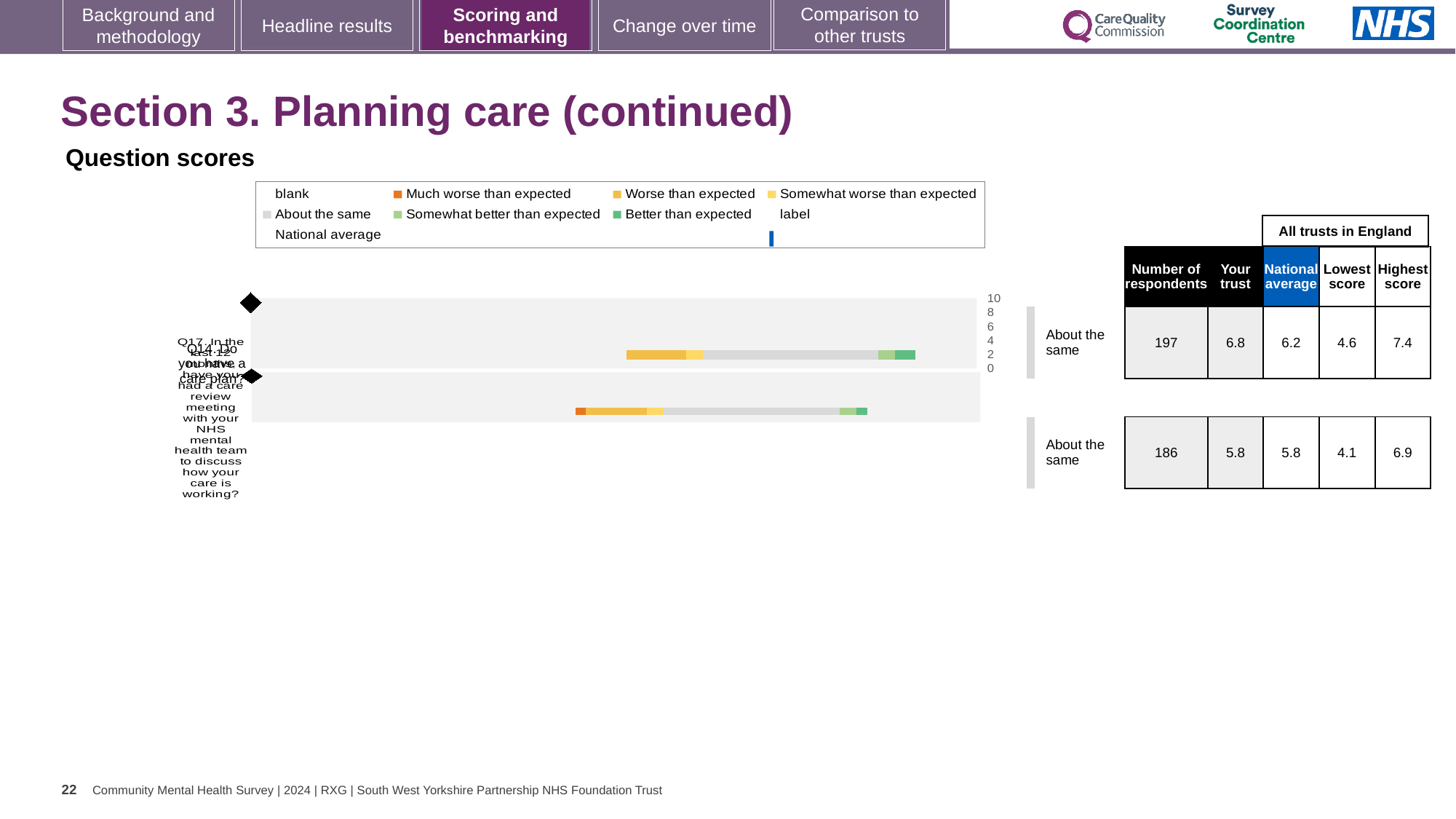
How many question rows are plotted in the chart? 2 What is the number of respondents for Q17 (the bottom row of the chart)? 186 What is the highest score among all trusts in England for the top row of the chart? 7.4 What benchmark category is shown next to the chart for Q17 (the bottom row)? About the same For the top row of the chart, what is the difference between the 'Your trust' score and the national average? 0.6 What is the national average for the top row of the chart? 6.2 What kind of chart is shown on the slide? bar chart What is the number of respondents for the top row of the chart? 197 For the top row of the chart, which is larger: the 'Your trust' score or the national average? Your trust For Q17 (the bottom row of the chart), what is the difference between the highest and lowest scores among all trusts in England? 2.8 What is the 'Your trust' score for the top row of the chart? 6.8 What is the lowest score among all trusts in England for Q17 (the bottom row of the chart)? 4.1